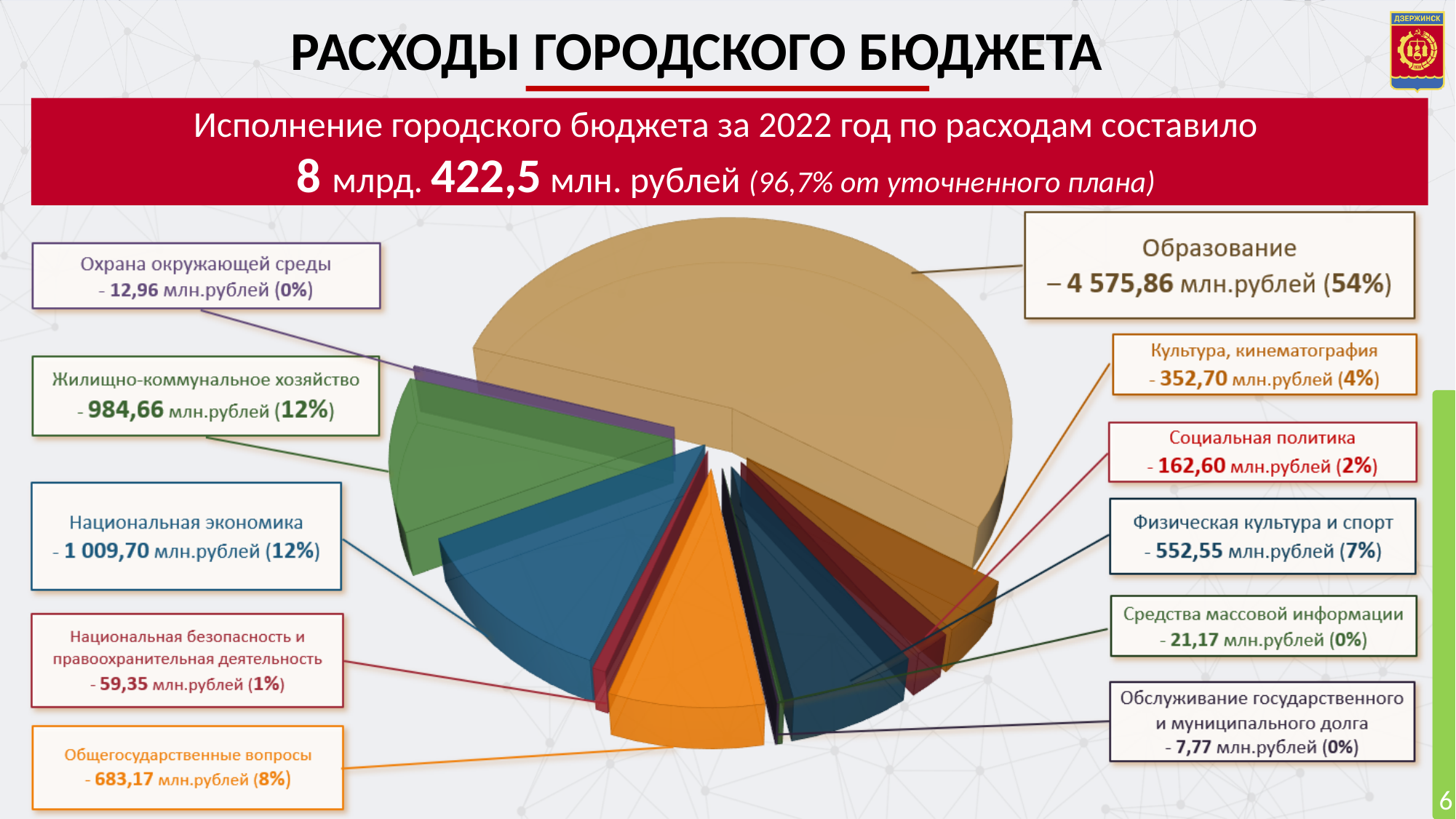
Which category has the smallest expenditure? Обслуживание государственного и муниципального долга What share of the pie does Образование account for? 54% What kind of chart is shown on the slide? Pie chart How many expenditure categories are labelled on the pie chart? 11 What is the value for Жилищно-коммунальное хозяйство? 984,66 млн.рублей What share of the pie does Культура, кинематография account for? 4% What is the difference between Национальная экономика and Жилищно-коммунальное хозяйство, in млн.рублей? 25,04 What is the value for Образование? 4 575,86 млн.рублей Which category has the largest expenditure? Образование What is the title of the slide? РАСХОДЫ ГОРОДСКОГО БЮДЖЕТА What is the value for Физическая культура и спорт? 552,55 млн.рублей Which is larger: Общегосударственные вопросы or Физическая культура и спорт? Общегосударственные вопросы